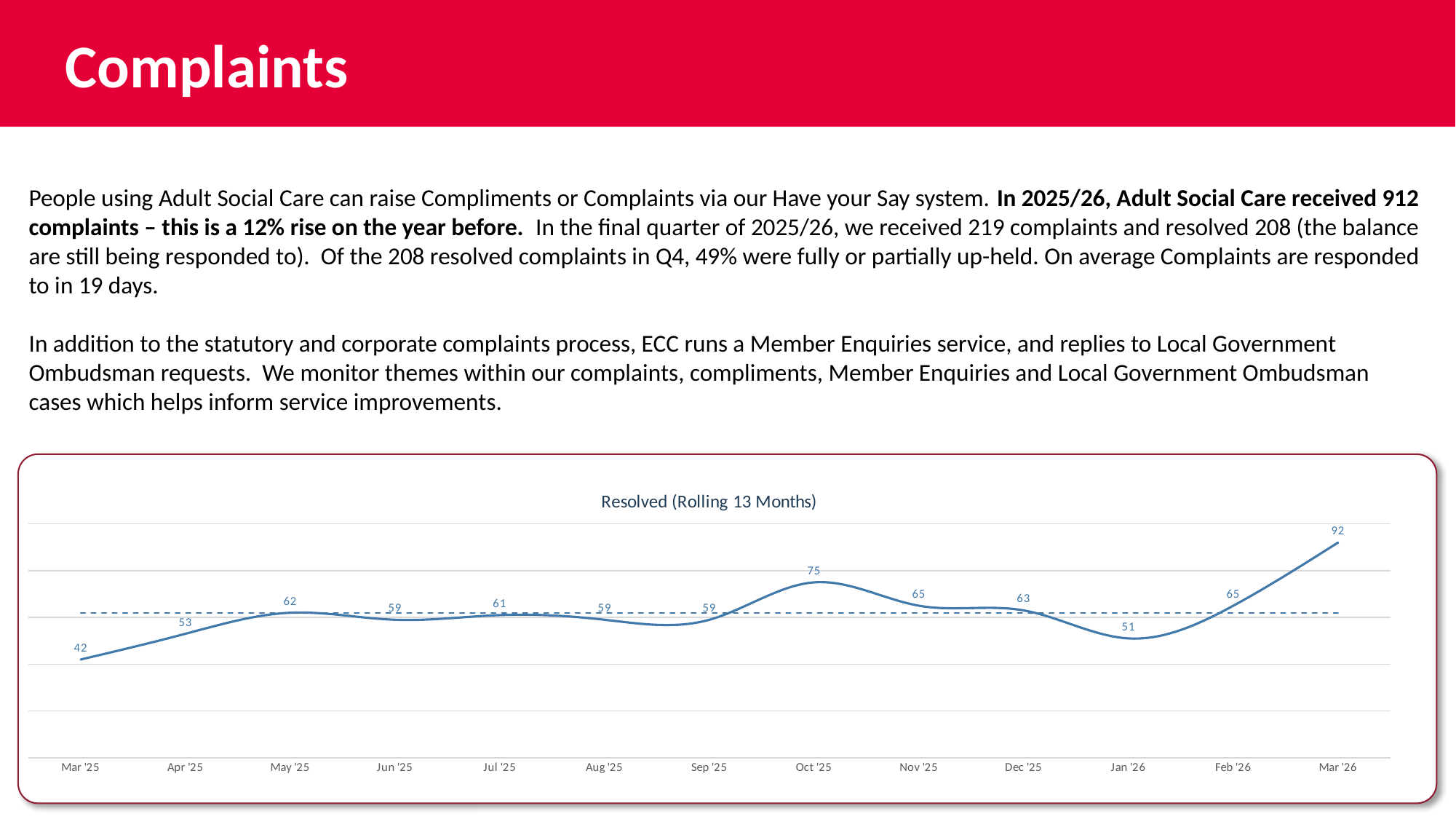
What is the difference between the values for Oct '25 and Mar '25? 33 What is the difference between the values for Mar '26 and Feb '26? 27 What is the value for Jan '26? 51 Do the values rise or fall from Dec '25 to Jan '26? fall What is the value for Mar '25? 42 What is the value for Oct '25? 75 Which month has the highest value? Mar '26 Which month has the lowest value? Mar '25 Which is larger, the value for Oct '25 or the value for Nov '25? Oct '25 How many months are plotted on the x axis? 13 What kind of chart is shown on the slide? line chart What is the title of the chart? Resolved (Rolling 13 Months)